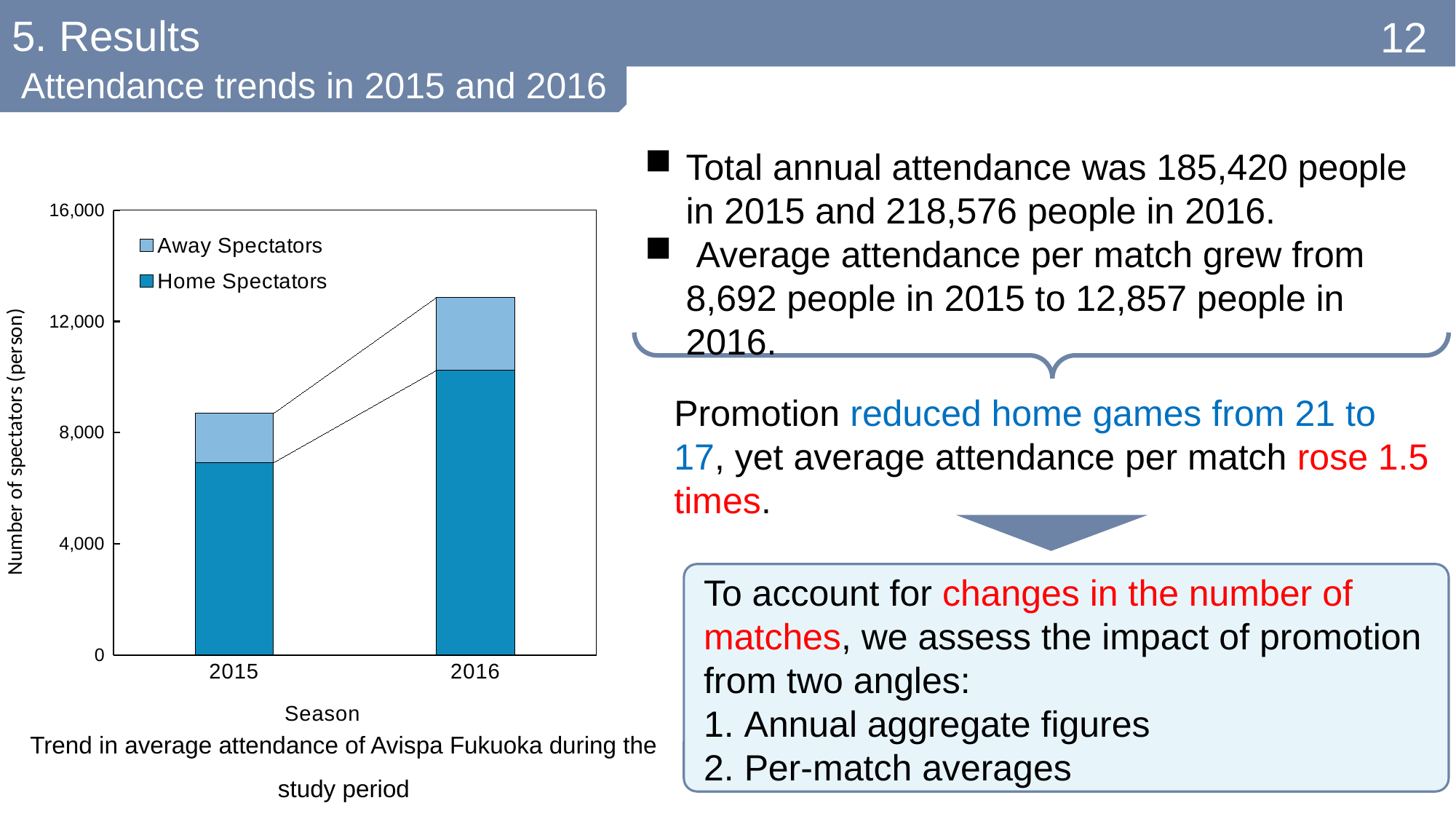
Is the total height of the stacked bar for 2016 greater or less than 12,000? greater Which two series are listed in the chart's legend? Away Spectators and Home Spectators What kind of chart is shown on the slide? Stacked bar chart What is the title of the chart's y axis? Number of spectators (person) Is the number of Home Spectators in 2016 greater or less than 8,000? greater Is the number of Home Spectators in 2015 greater or less than 8,000? less Which season has the larger number of Home Spectators, 2015 or 2016? 2016 How many series does the chart's legend list? 2 Does the total number of spectators rise or fall from 2015 to 2016? rise How many seasons are shown on the x axis of the chart? 2 Which season has the larger number of Away Spectators, 2015 or 2016? 2016